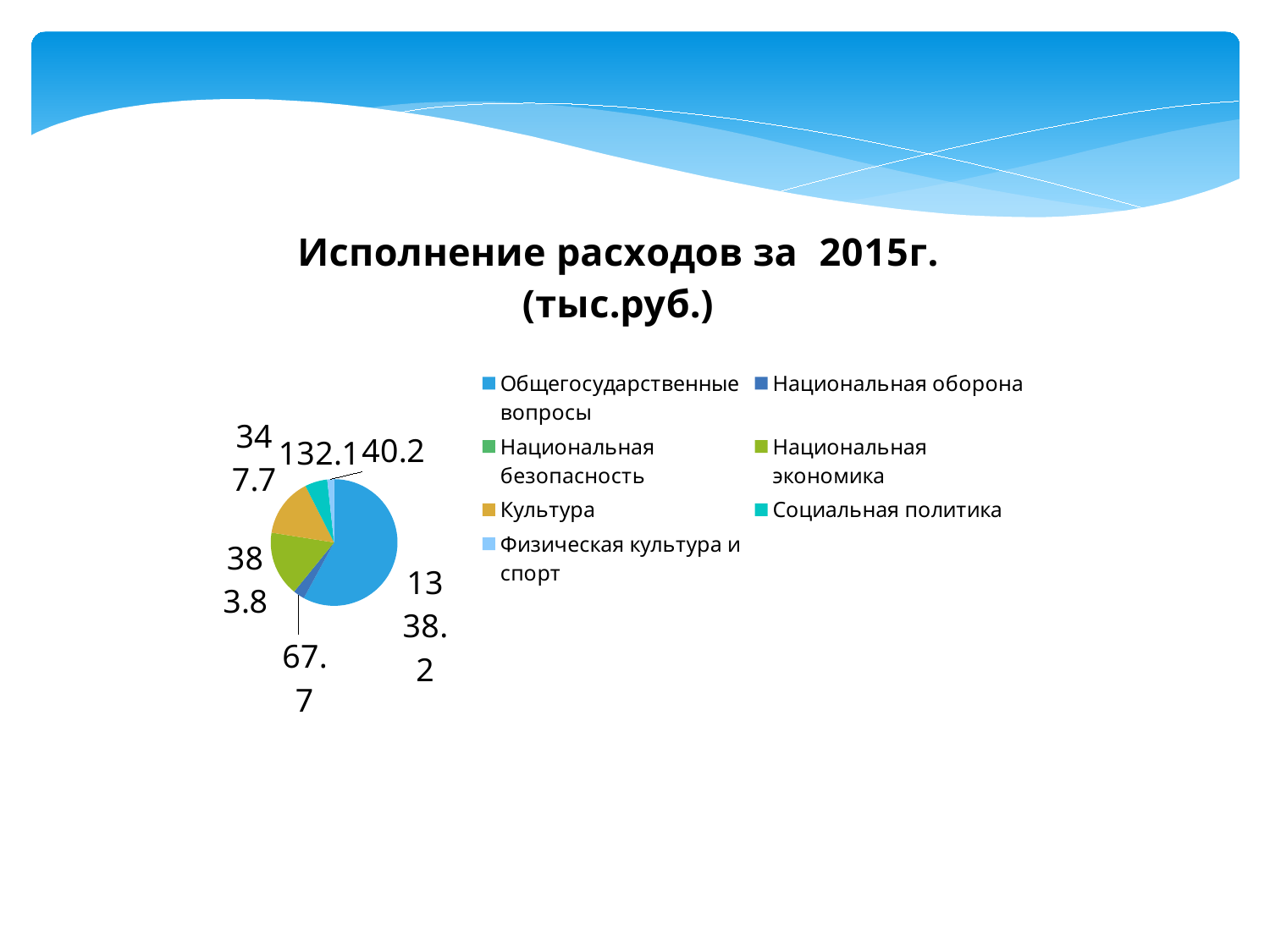
What is the value for Социальная политика? 132.1 What is the value for Культура? 347.7 What is the value for Национальная оборона? 67.7 What colour is the slice for Общегосударственные вопросы? blue Which is larger, the value for Культура or the value for Социальная политика? Культура What is the title of the chart? Исполнение расходов за 2015г. (тыс.руб.) What kind of chart is shown on the slide? pie chart How many entries does the chart legend list? 7 What is the value for Физическая культура и спорт? 40.2 What is the difference between the values for Общегосударственные вопросы and Культура? 990.5 Which category has the largest slice of the pie? Общегосударственные вопросы What is the value for Общегосударственные вопросы? 1338.2